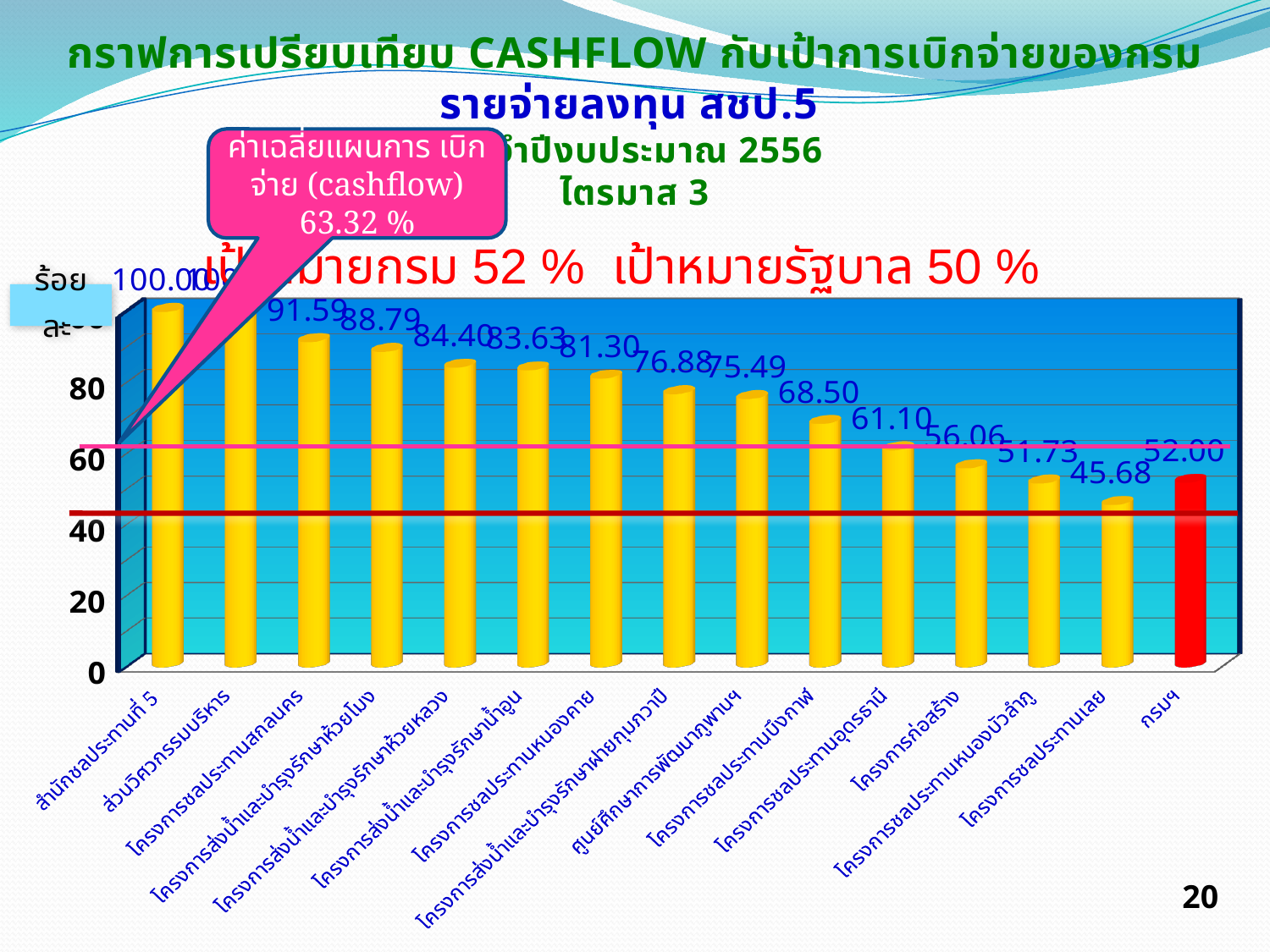
How many categories are shown on the x axis? 15 What is the difference between the values for โครงการชลประทานอุดรธานี and โครงการก่อสร้าง? 5.04 Which category has the lowest value? โครงการชลประทานเลย What cashflow average percentage is shown in the pink callout? 63.32 % What is the value for ศูนย์ศึกษาการพัฒนาภูพานฯ? 75.49 What is the value for กรมฯ? 52.00 What kind of chart is shown on the slide? bar chart What is the value for โครงการชลประทานสกลนคร? 91.59 Which is larger, the value for โครงการชลประทานบึงกาฬ or โครงการชลประทานอุดรธานี? โครงการชลประทานบึงกาฬ Do the values of the yellow bars generally rise or fall from left to right? fall Is the value for โครงการส่งน้ำและบำรุงรักษาห้วยโมง greater or less than 80? greater What is the value for โครงการชลประทานเลย? 45.68